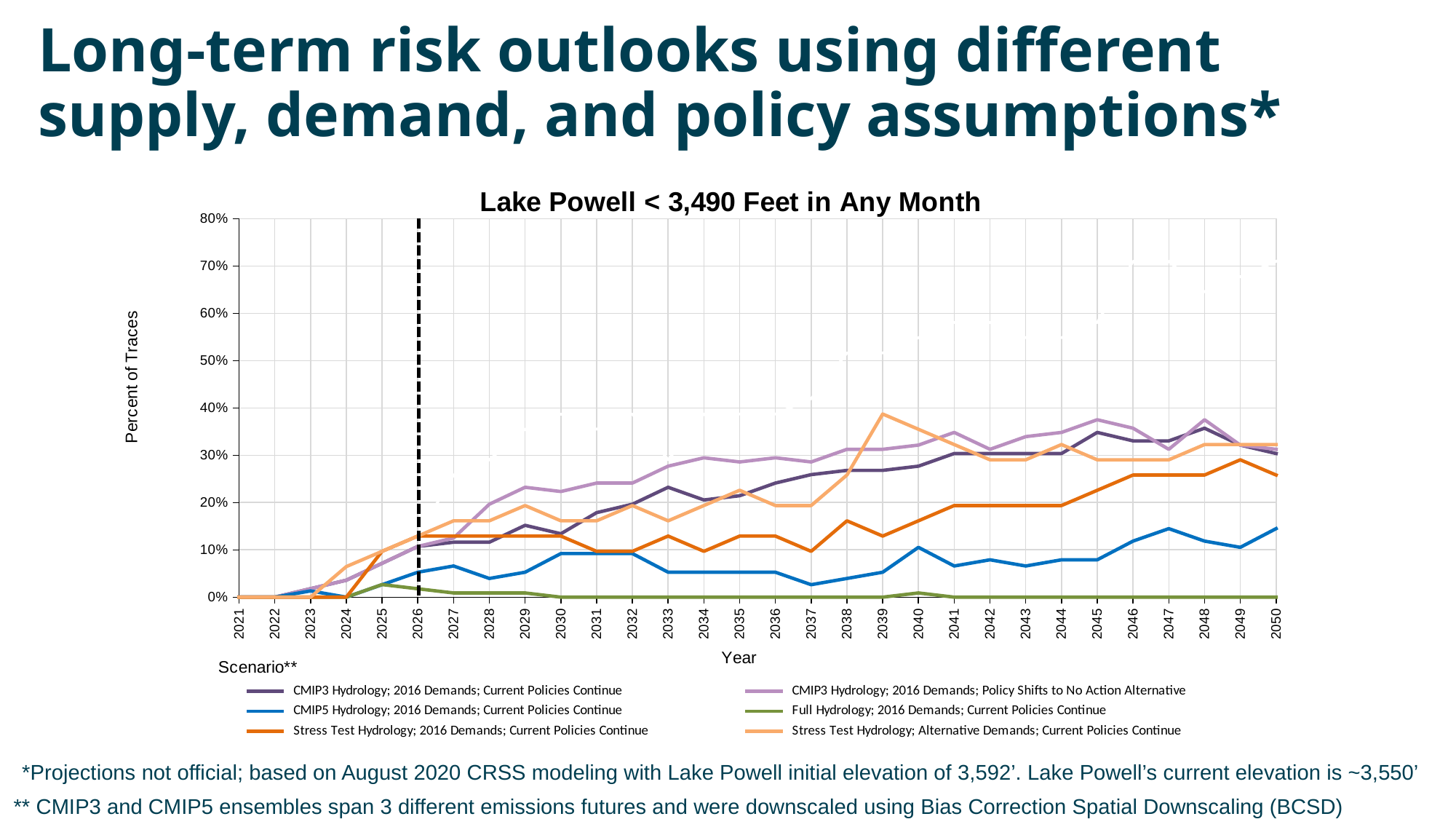
Is the value for 'CMIP3 Hydrology; 2016 Demands; Policy Shifts to No Action Alternative' in 2045 greater or less than 30%? greater Which series has the highest value in 2039? Stress Test Hydrology; Alternative Demands; Current Policies Continue What is the label on the y axis? Percent of Traces What is the title of the chart? Lake Powell < 3,490 Feet in Any Month In 2050, which is larger: the value for 'CMIP5 Hydrology; 2016 Demands; Current Policies Continue' or for 'Stress Test Hydrology; 2016 Demands; Current Policies Continue'? Stress Test Hydrology; 2016 Demands; Current Policies Continue How many years are shown along the x axis? 30 What kind of chart is shown on the slide? Line chart How many series does the legend list? 6 Is the value for 'CMIP5 Hydrology; 2016 Demands; Current Policies Continue' in 2050 greater or less than 10%? greater Is the value for 'Stress Test Hydrology; 2016 Demands; Current Policies Continue' in 2050 greater or less than 20%? greater Which series has the lowest values across the projection period? Full Hydrology; 2016 Demands; Current Policies Continue What is the value for 'Full Hydrology; 2016 Demands; Current Policies Continue' in 2050? 0%